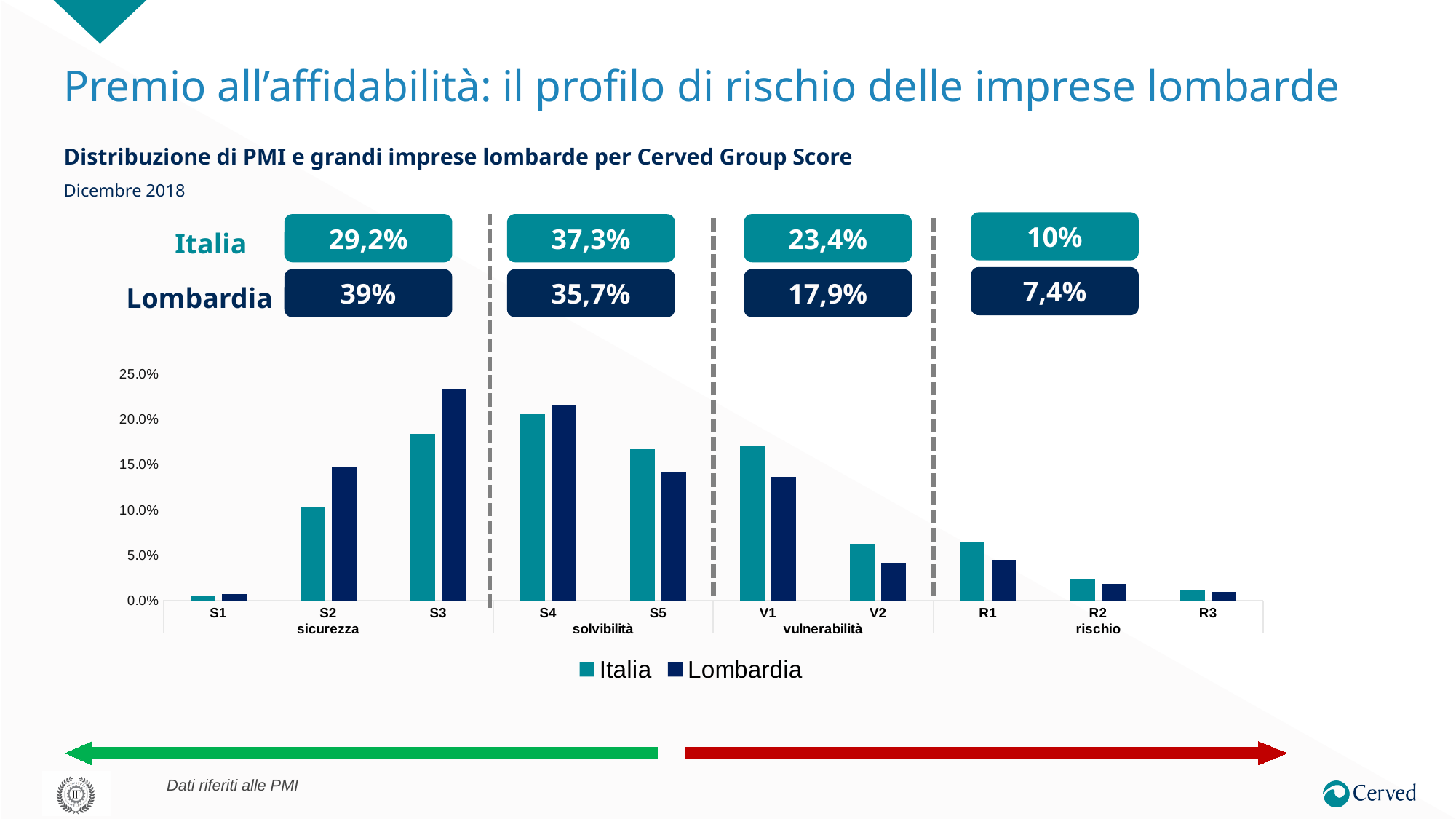
For S3, which series has the larger bar, Italia or Lombardia? Lombardia Is the Lombardia value for S3 greater or less than 20.0%? greater By how many percentage points does the Lombardia sicurezza share (39%) exceed the Italia sicurezza share (29,2%)? 9,8 How many series does the chart legend list? 2 What is the Lombardia share shown in the box for the sicurezza group? 39% Is the Lombardia value for V1 greater or less than 15.0%? less How many score categories are shown along the x axis of the chart? 10 What kind of chart is shown on the slide? bar chart What is the Lombardia share shown in the box for the rischio group? 7,4% Which category has the lowest Italia bar in the chart? S1 Which category has the tallest bar in the chart? S3 (Lombardia) What is the Italia share shown in the box for the solvibilità group? 37,3%